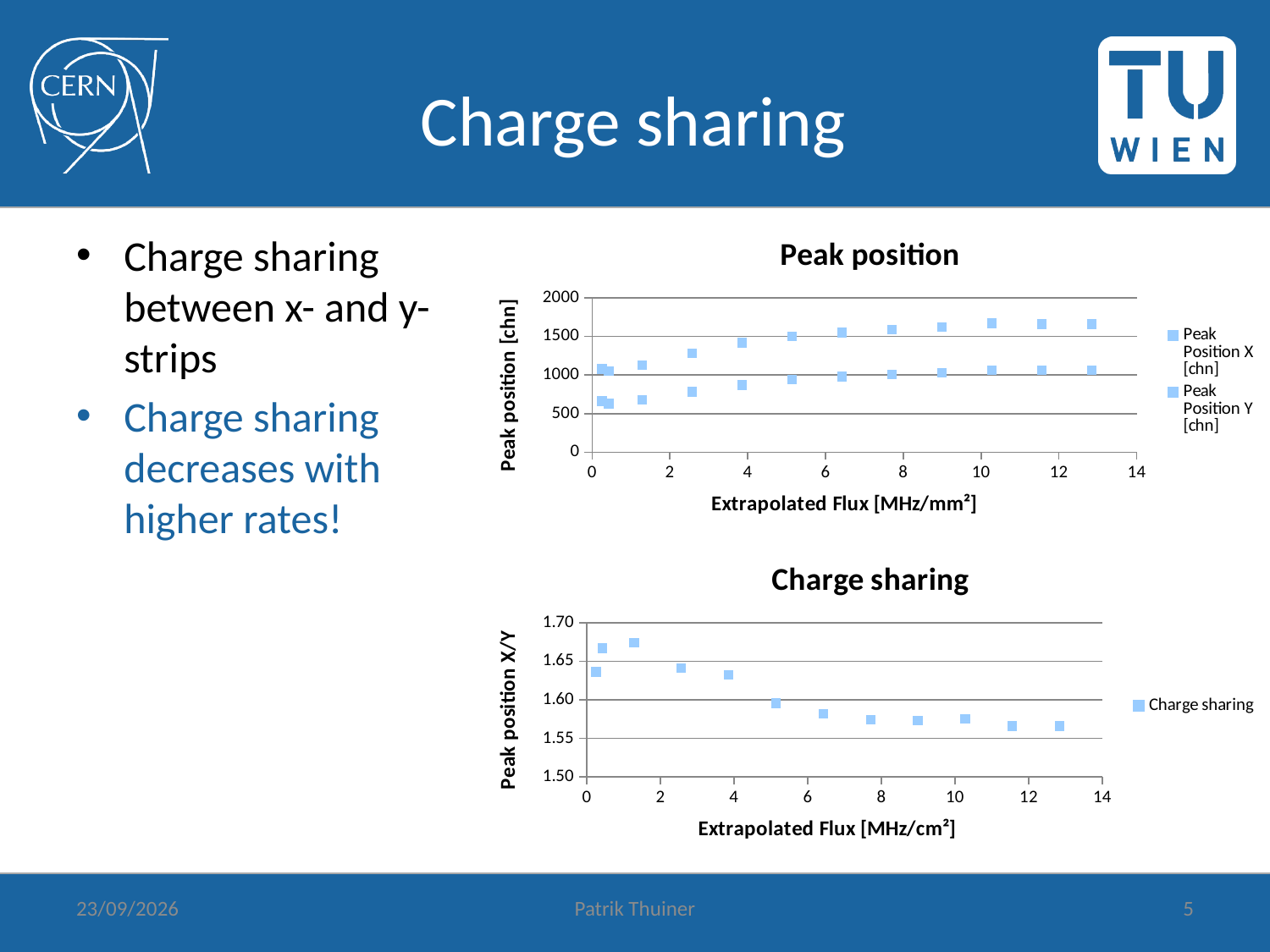
In the 'Charge sharing' chart, do the values rise or fall as the extrapolated flux increases? fall What is the y-axis label of the 'Charge sharing' chart? Peak position X/Y How many data points are plotted in the 'Charge sharing' chart? 12 In the 'Peak position' chart, is the Peak Position X [chn] value at the highest flux (around 13 MHz/mm²) greater or less than 1500? greater What kind of chart is the 'Charge sharing' chart? scatter chart What kind of chart is the 'Peak position' chart? scatter chart In the 'Peak position' chart, is the Peak Position Y [chn] value at the lowest flux (near 0 MHz/mm²) greater or less than 1000? less How many series does the legend of the 'Charge sharing' chart list? 1 In the 'Peak position' chart, do the Peak Position X [chn] values rise or fall as the extrapolated flux increases? rise In the 'Peak position' chart, at the highest flux (around 13 MHz/mm²), which series has the larger value, Peak Position X [chn] or Peak Position Y [chn]? Peak Position X [chn] In the 'Charge sharing' chart, is the value at the highest flux (around 13 MHz/cm²) greater or less than 1.60? less How many series does the legend of the 'Peak position' chart list? 2